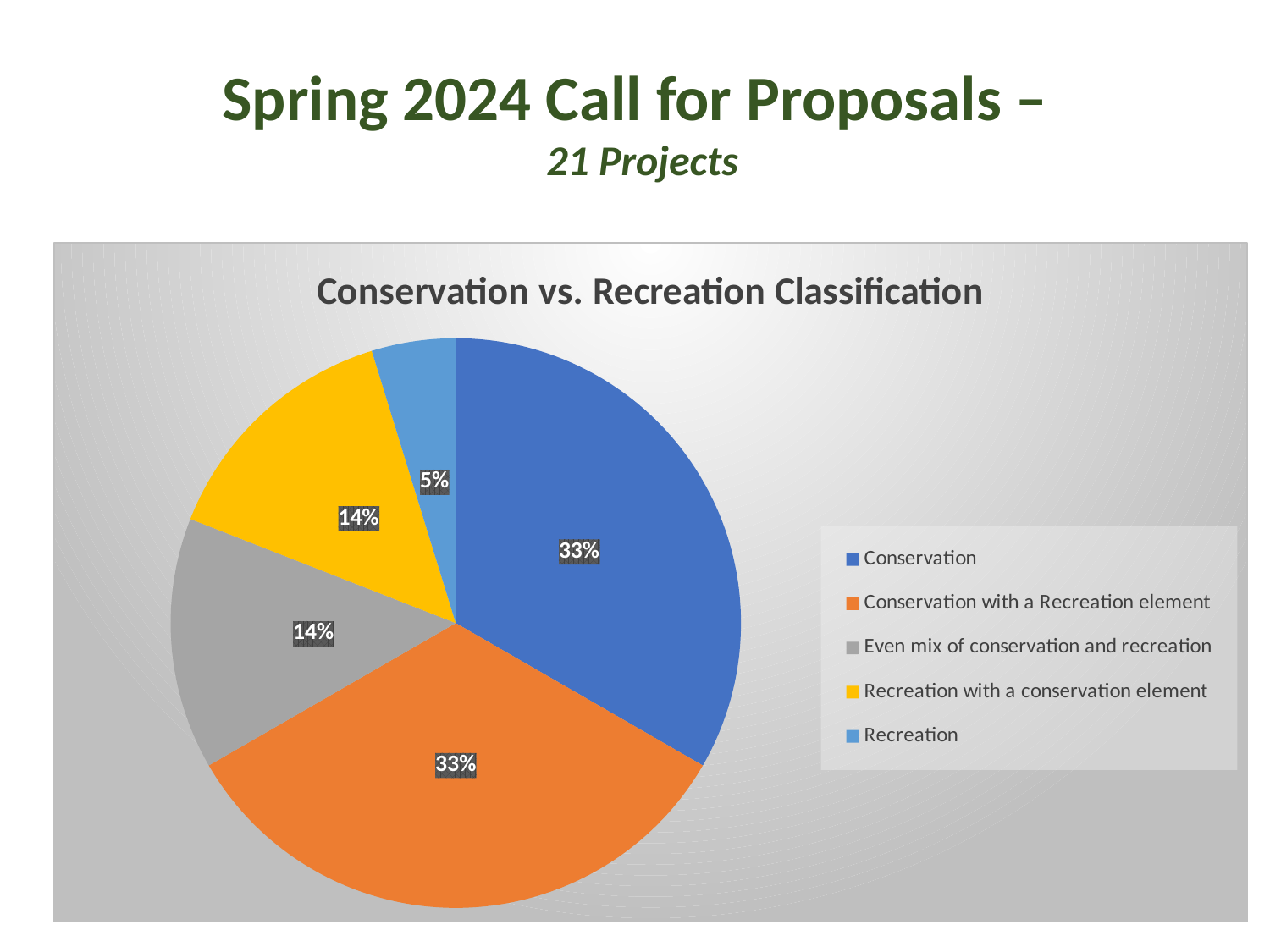
What kind of chart is shown on the slide? Pie chart What share of the pie does Recreation represent? 5% Which colour represents Recreation with a conservation element in the legend? Yellow Which category has the smallest slice of the pie? Recreation What is the title of the chart? Conservation vs. Recreation Classification What share of the pie does Recreation with a conservation element represent? 14% What is the difference in percentage points between the Conservation slice and the Recreation slice? 28 How many slices does the pie chart have? 5 What share of the pie does Even mix of conservation and recreation represent? 14% What share of the pie does Conservation represent? 33% What share of the pie does Conservation with a Recreation element represent? 33% Which is larger: the slice for Conservation or the slice for Recreation? Conservation